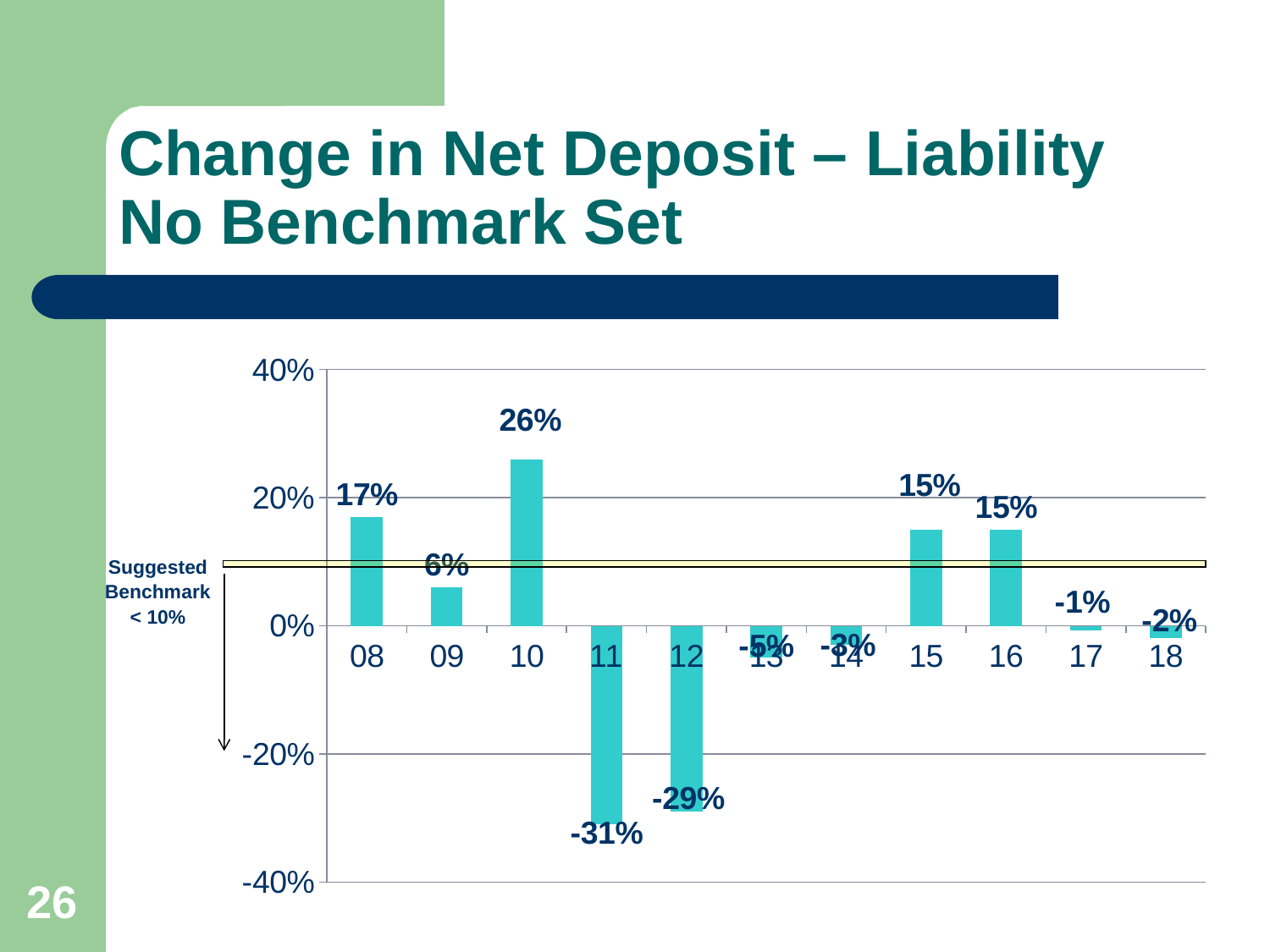
Which year has the lowest value? 11 What is the value for 11? -31% What is the difference between the values for 10 and 08? 9% What is the value for 08? 17% Which is larger, the value for 08 or the value for 09? 08 What is the value for 17? -1% Which year has the highest value? 10 What is the value for 10? 26% What suggested benchmark is noted on the chart? < 10% How many years are shown on the x axis? 11 What kind of chart is this? bar chart Is the value for 15 greater or less than 20%? less